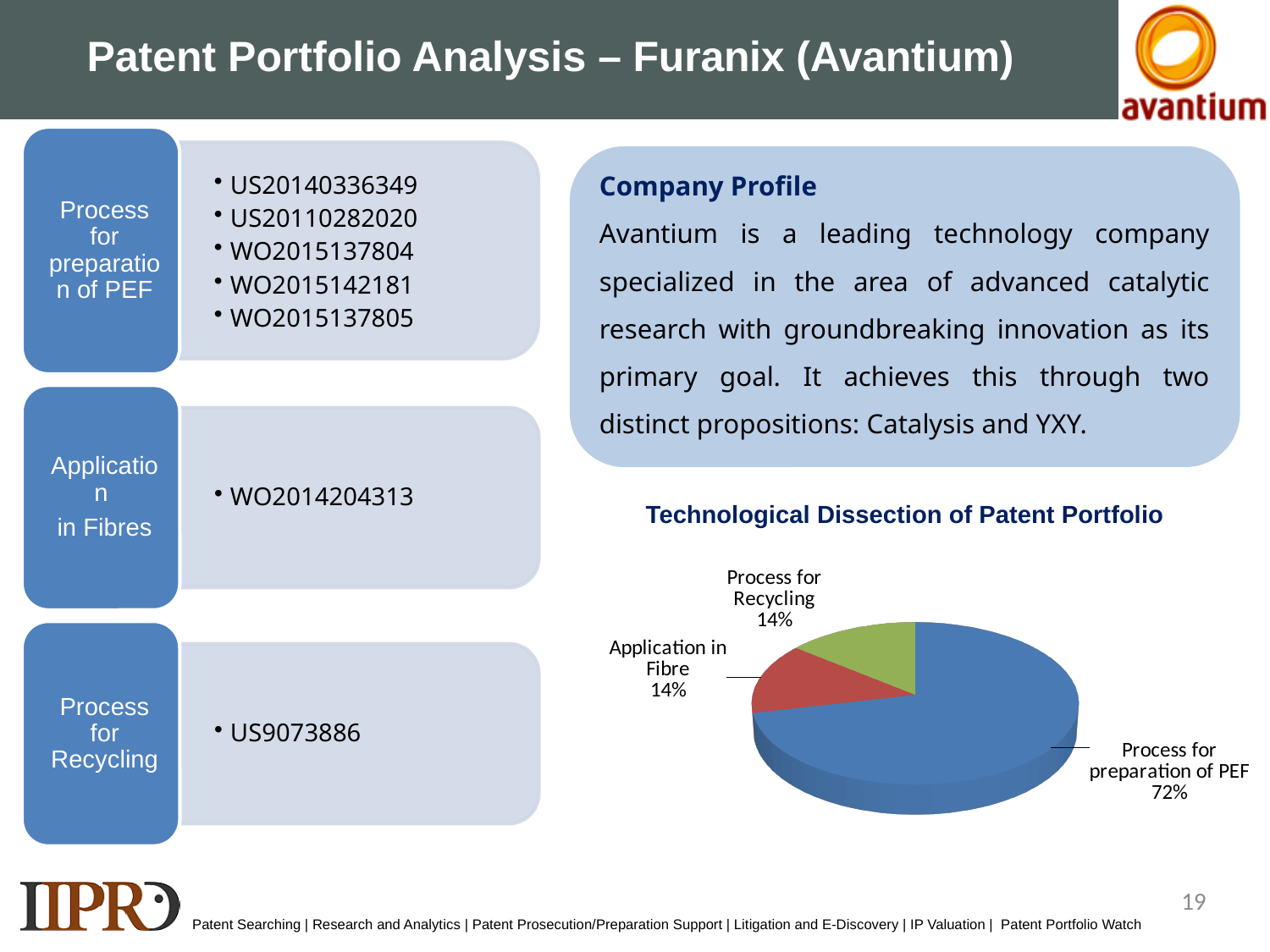
What share of the pie chart does 'Application in Fibre' represent? 14% What type of chart is shown on the slide? Pie chart What share of the pie chart does 'Process for preparation of PEF' represent? 72% What share of the pie chart does 'Process for Recycling' represent? 14% Which is larger in the pie chart: 'Process for preparation of PEF' or 'Application in Fibre'? Process for preparation of PEF What is the difference in percentage points between 'Process for preparation of PEF' and 'Process for Recycling'? 58 Is the share for 'Process for preparation of PEF' greater or less than 50%? greater Which category has the largest slice in the pie chart? Process for preparation of PEF What is the title of the chart on the slide? Technological Dissection of Patent Portfolio What colour is the 'Process for preparation of PEF' slice in the pie chart? Blue How many slices does the pie chart have? 3 What is the combined share of 'Process for Recycling' and 'Application in Fibre' in the pie chart? 28%